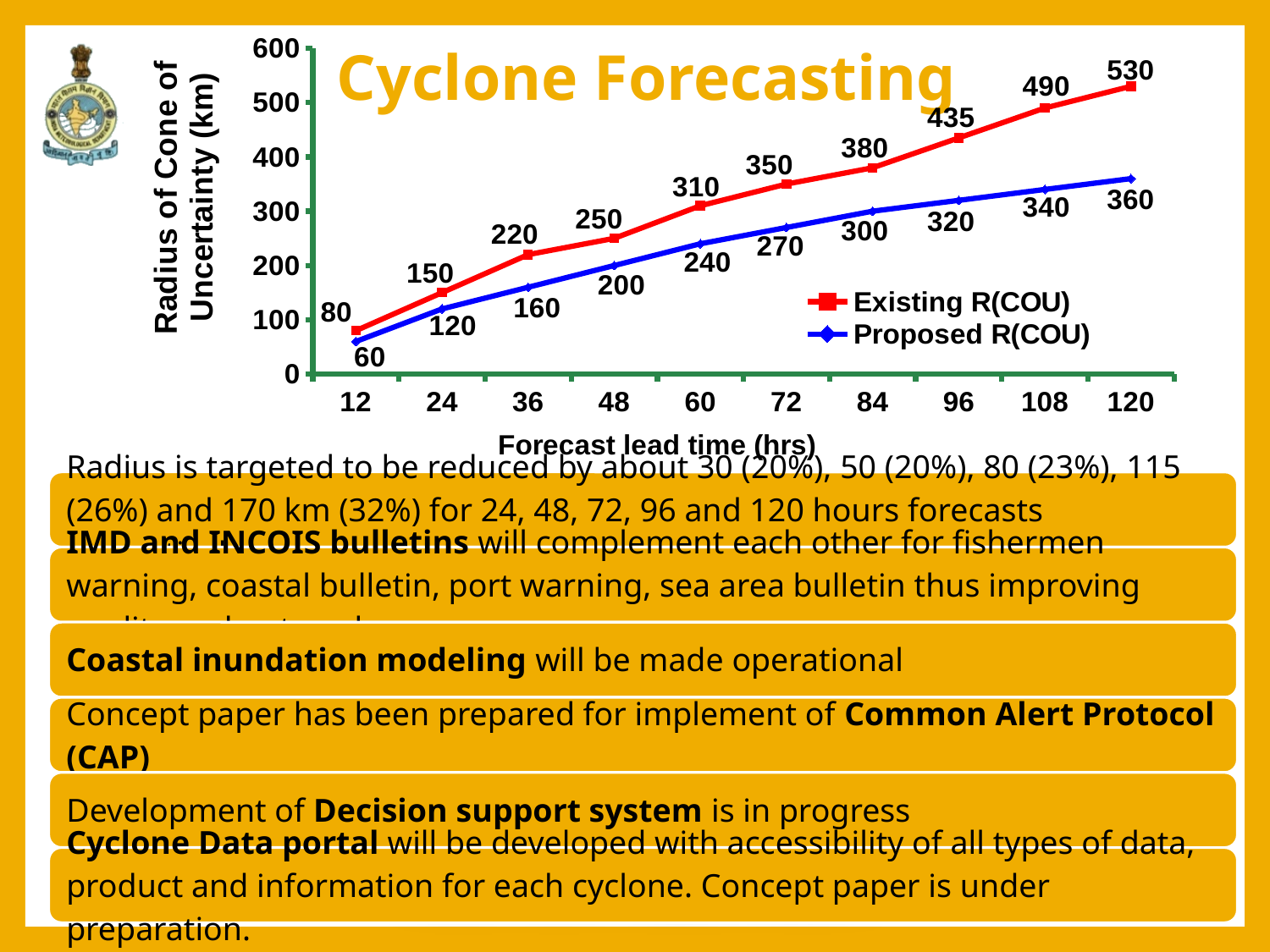
What is the Proposed R(COU) value at a forecast lead time of 48 hrs? 200 What is the difference between the Existing R(COU) and Proposed R(COU) at 120 hrs? 170 Which is larger at 96 hrs: Existing R(COU) or Proposed R(COU)? Existing R(COU) At which forecast lead time is the Proposed R(COU) lowest? 12 How many forecast lead time points are plotted on the x axis? 10 Do the Existing R(COU) values rise or fall as forecast lead time increases? Rise What is the Existing R(COU) value at 120 hrs? 530 At which forecast lead time is the Existing R(COU) highest? 120 What is the Existing R(COU) value at a forecast lead time of 72 hrs? 350 What kind of chart is shown on the slide? Line chart How many series does the legend list? 2 What is the difference between the Existing R(COU) and Proposed R(COU) at 24 hrs? 30